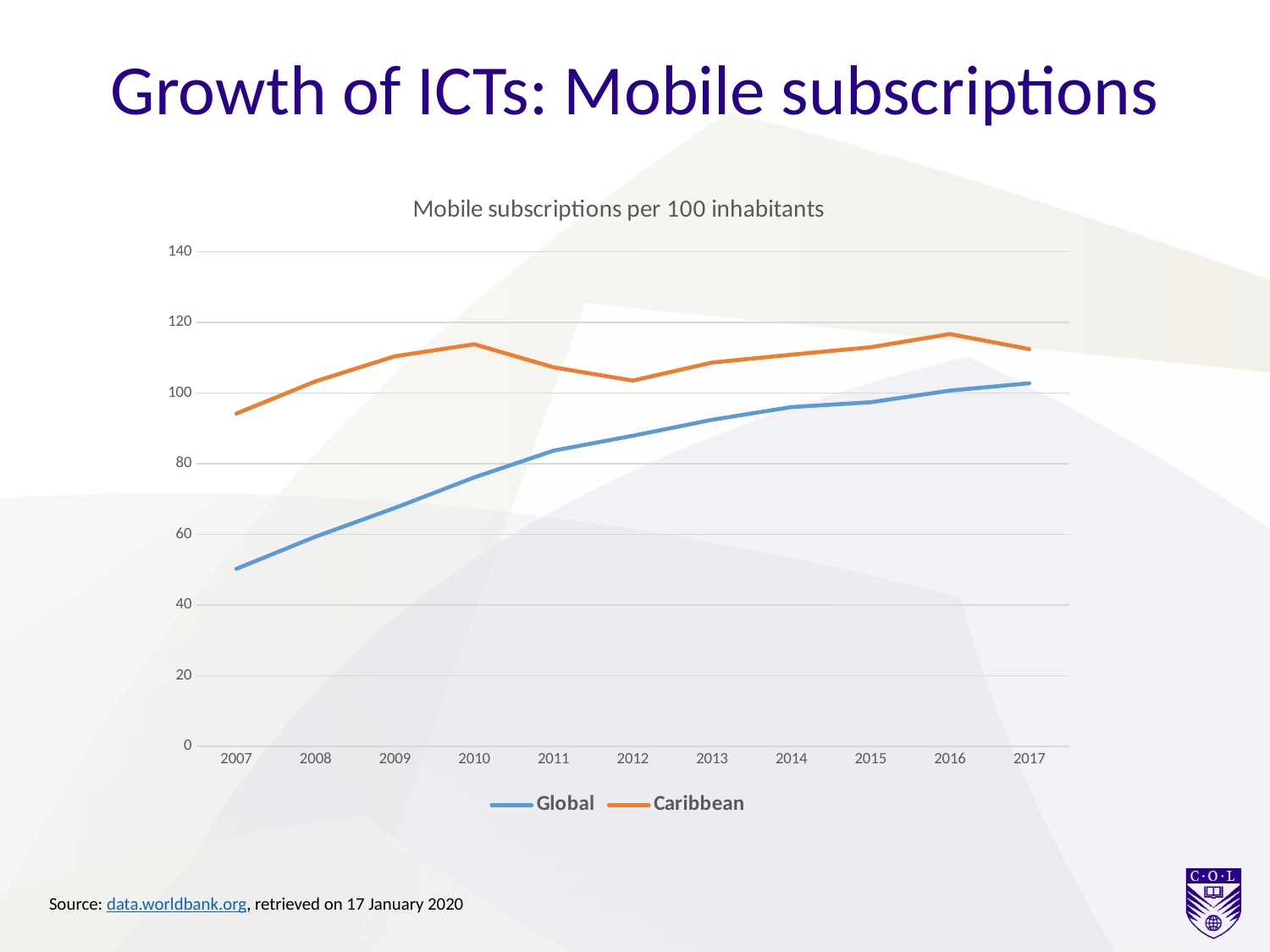
Is the Global value for 2011 greater or less than 80? greater In which year is the Global series at its lowest value? 2007 In which year does the Caribbean series reach its highest value? 2016 What kind of chart is shown on the slide? line chart Is the Global value for 2007 greater or less than 60? less How many years are shown on the x axis? 11 How many series does the legend list? 2 In 2010, which series has the higher value, Global or Caribbean? Caribbean Which colour is used for the Caribbean line? orange What is the title of the chart? Mobile subscriptions per 100 inhabitants Is the Caribbean value for 2016 greater or less than 100? greater